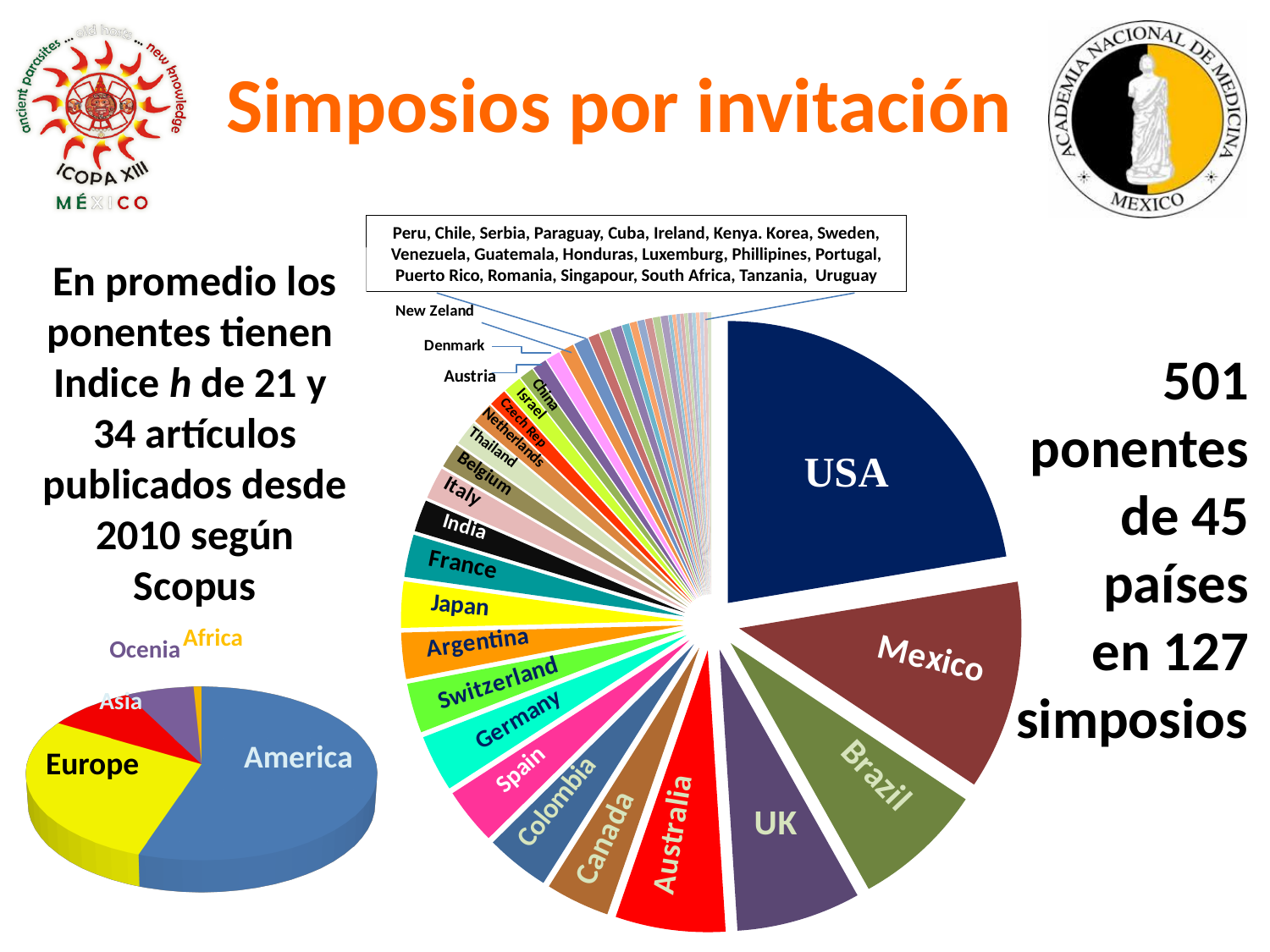
In the large country pie chart, which slice is larger, France or India? France What kind of chart is the small chart at the bottom left of the slide? pie chart What kind of chart is the large chart in the centre of the slide? pie chart In the small continent pie chart at the bottom left, which region has the smallest slice? Africa In the large country pie chart, which country has the largest slice? USA In the large country pie chart, which slice is larger, Mexico or Brazil? Mexico In the large country pie chart, which slice is larger, USA or Mexico? USA In the large country pie chart, what colour is the USA slice? dark blue In the small continent pie chart at the bottom left, which region has the largest slice? America How many regions are shown in the small continent pie chart at the bottom left? 5